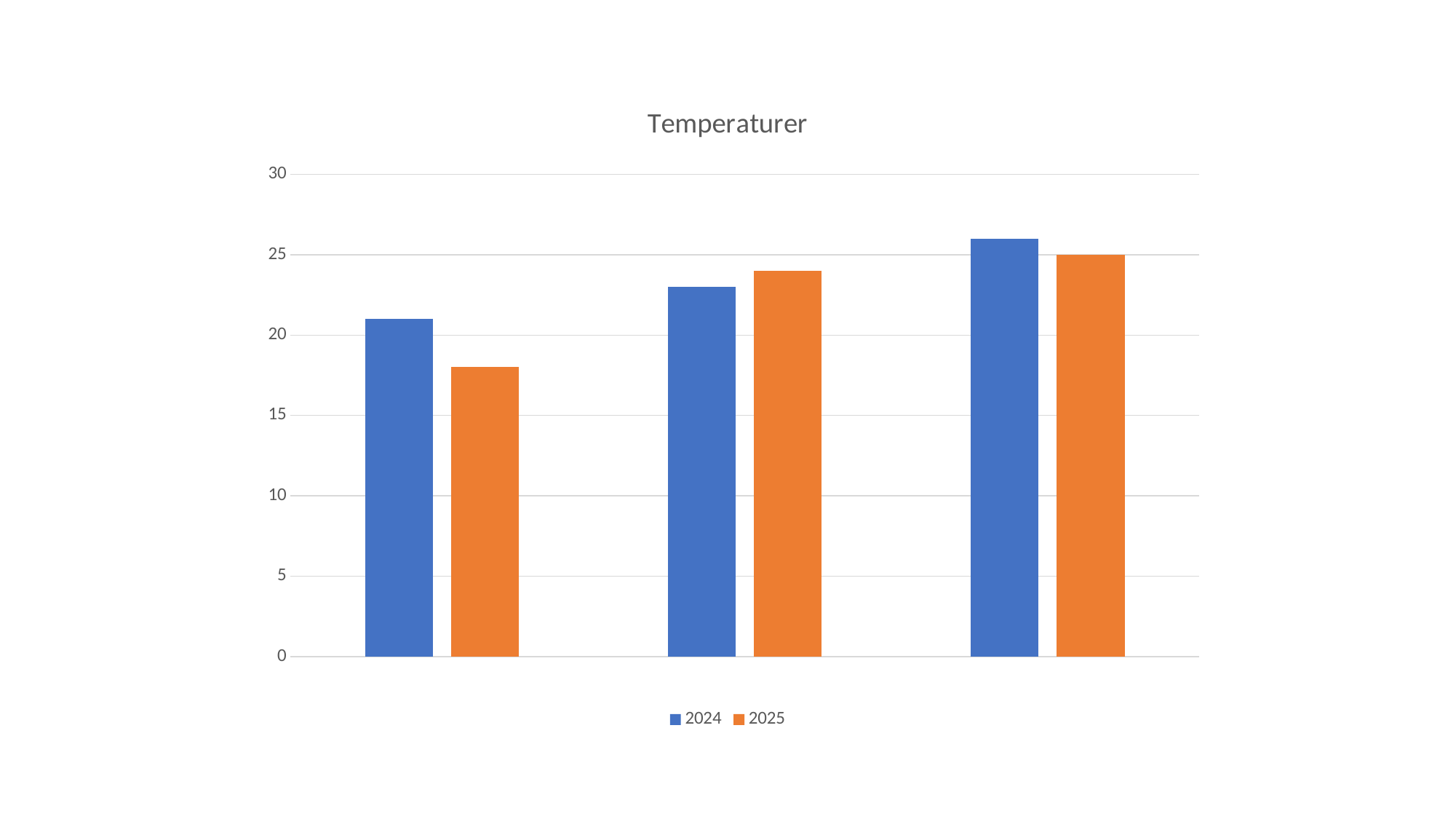
Which series are listed in the legend? 2024 and 2025 Which group has the lowest 2025 bar? the first (leftmost) group What is the value of the 2025 bar in the third (rightmost) group? 25 What kind of chart is shown on the slide? bar chart Is the value of the 2024 bar in the first (leftmost) group greater or less than 20? greater How many groups of bars are plotted in the chart? 3 How many series does the legend list? 2 Is the value of the 2024 bar in the third (rightmost) group greater or less than 25? greater In the first (leftmost) group, which series has the larger value, 2024 or 2025? 2024 Is the value of the 2025 bar in the first (leftmost) group greater or less than 20? less What is the title of the chart? Temperaturer Which group has the highest 2024 bar? the third (rightmost) group